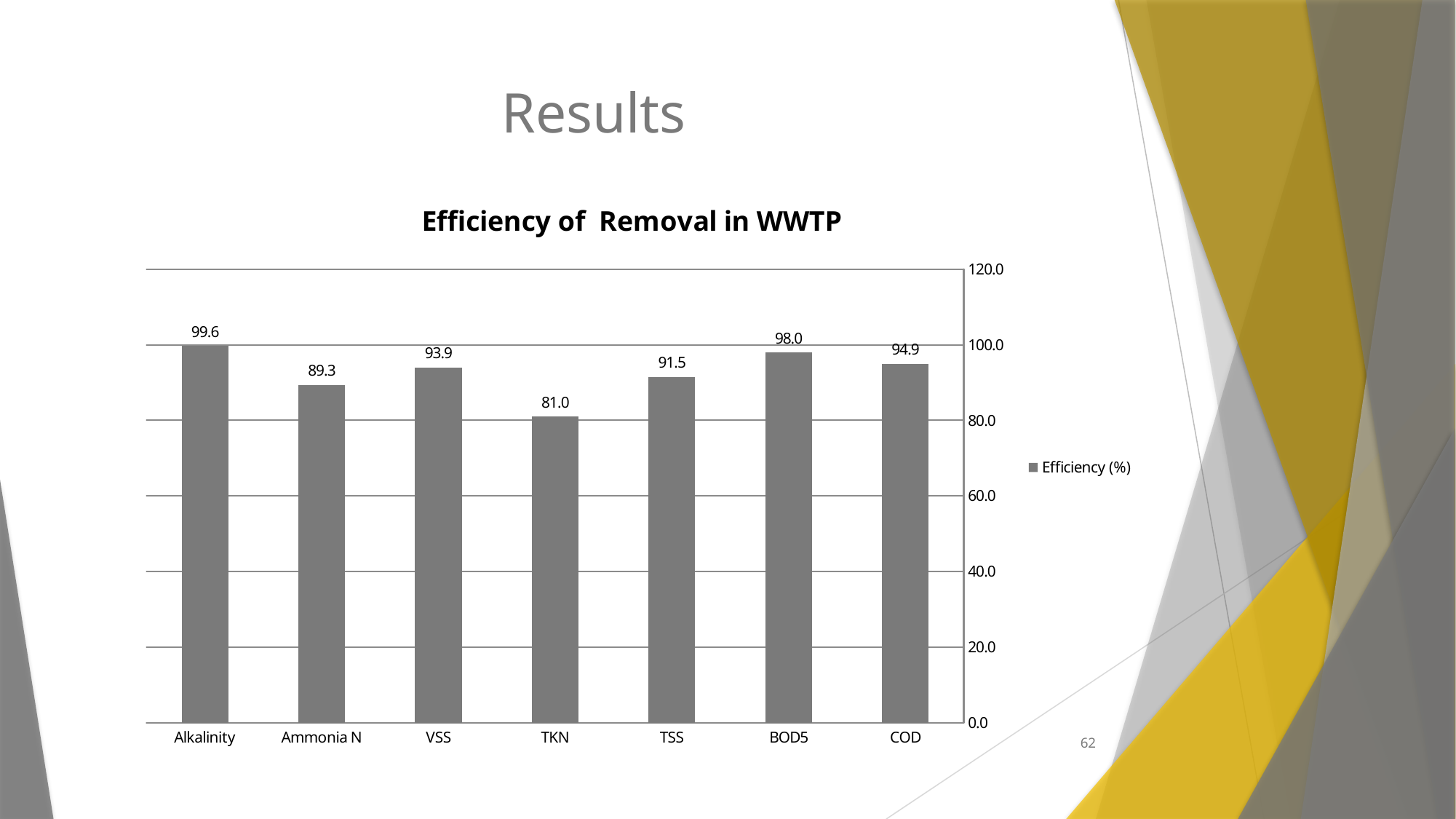
Which category has the highest removal efficiency? Alkalinity What is the title of the chart? Efficiency of Removal in WWTP What is the removal efficiency for BOD5? 98.0 What is the removal efficiency for Alkalinity? 99.6 Which has a higher removal efficiency, VSS or TSS? VSS Is the removal efficiency for TKN greater or less than 100.0? less How many categories are shown on the x axis? 7 What is the removal efficiency for TKN? 81.0 What is the difference between the removal efficiency for COD and for Ammonia N? 5.6 What kind of chart is shown on the slide? bar chart Which category has the lowest removal efficiency? TKN How many series does the legend list? 1